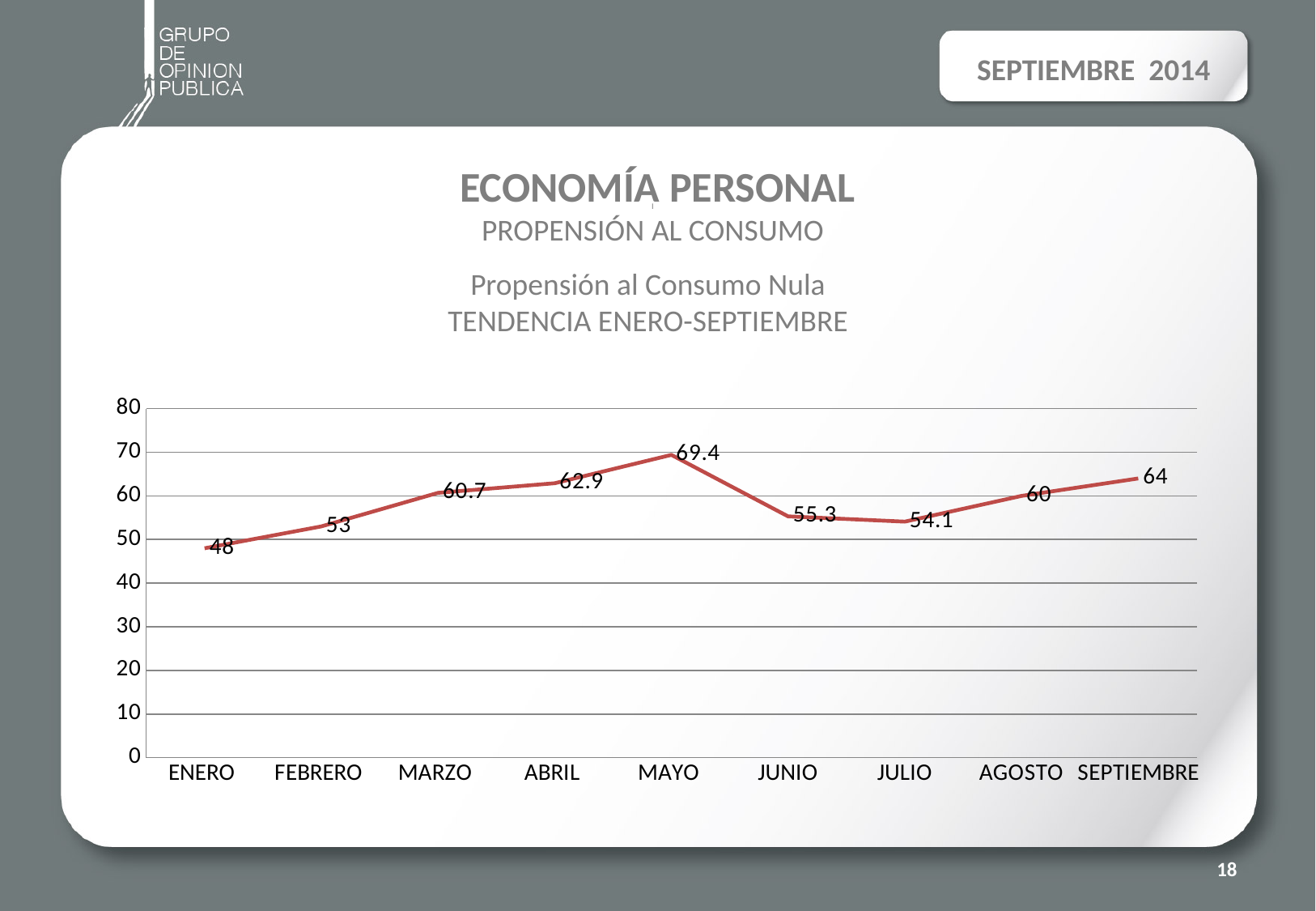
Is the value for JULIO greater or less than 60? less Which month has the highest value? MAYO Which month has the lowest value? ENERO How many months are plotted on the x axis? 9 What is the subtitle of the chart below 'Propensión al Consumo Nula'? TENDENCIA ENERO-SEPTIEMBRE Do the values rise or fall from ENERO to MAYO? rise What is the value for ENERO? 48 What is the difference between the values for MAYO and JUNIO? 14.1 What kind of chart is shown on the slide? line chart What is the value for SEPTIEMBRE? 64 What is the value for MAYO? 69.4 Which is larger, the value for ABRIL or the value for AGOSTO? ABRIL